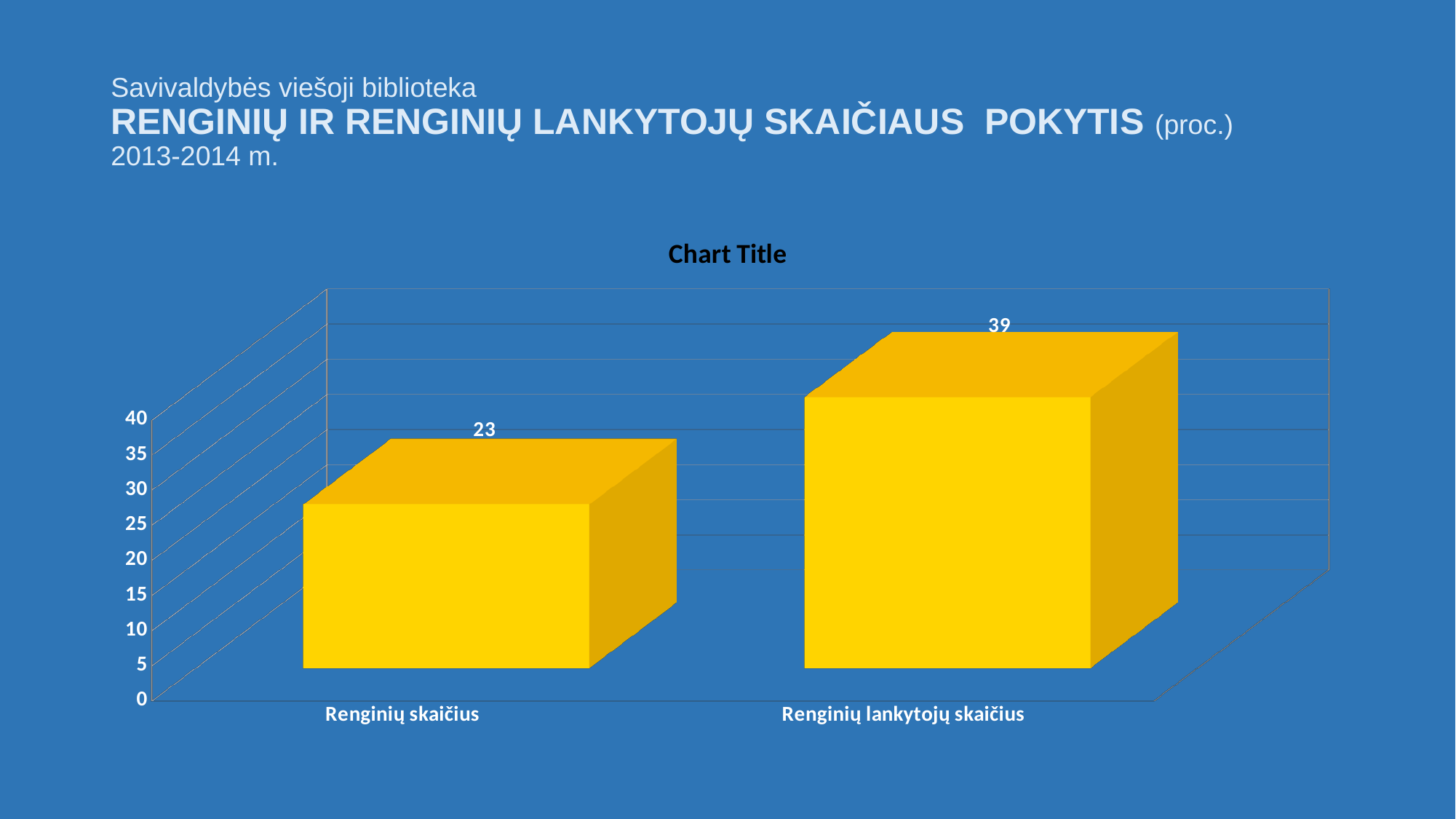
How many categories are shown in the chart? 2 Which is larger, the value for Renginių skaičius or the value for Renginių lankytojų skaičius? Renginių lankytojų skaičius Is the value for Renginių lankytojų skaičius greater or less than 35? greater Which category has the highest value? Renginių lankytojų skaičius What is the value for Renginių skaičius? 23 What kind of chart is shown on the slide? bar chart What colour are the bars in the chart? yellow Which category has the lowest value? Renginių skaičius What is the value for Renginių lankytojų skaičius? 39 What is the difference between the values for Renginių lankytojų skaičius and Renginių skaičius? 16 Is the value for Renginių skaičius greater or less than 30? less What is the title shown above the chart? Chart Title